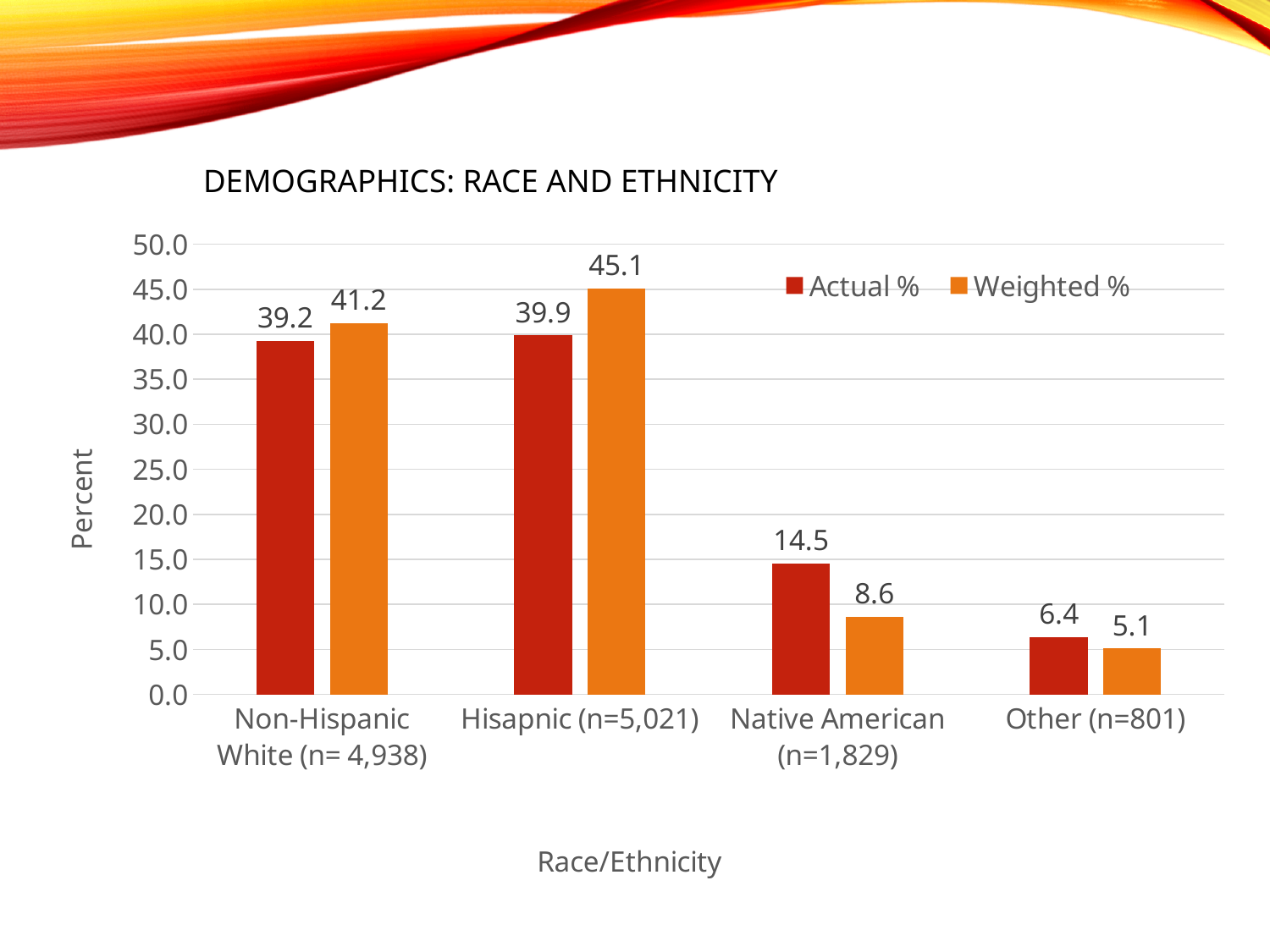
For Non-Hispanic White (n= 4,938), which is larger: the Actual % or the Weighted % value? Weighted % What type of chart is shown on the slide? Bar chart How many categories are shown on the x axis? 4 What is the Actual % value for Non-Hispanic White (n= 4,938)? 39.2 Which category has the lowest Actual % value? Other (n=801) What is the Weighted % value for Hisapnic (n=5,021)? 45.1 Which category has the highest Weighted % value? Hisapnic (n=5,021) What is the Weighted % value for Native American (n=1,829)? 8.6 What is the difference between the Weighted % values for Hisapnic (n=5,021) and Non-Hispanic White (n= 4,938)? 3.9 How many series does the legend list? 2 What is the difference between the Actual % and Weighted % values for Native American (n=1,829)? 5.9 What is the Actual % value for Other (n=801)? 6.4